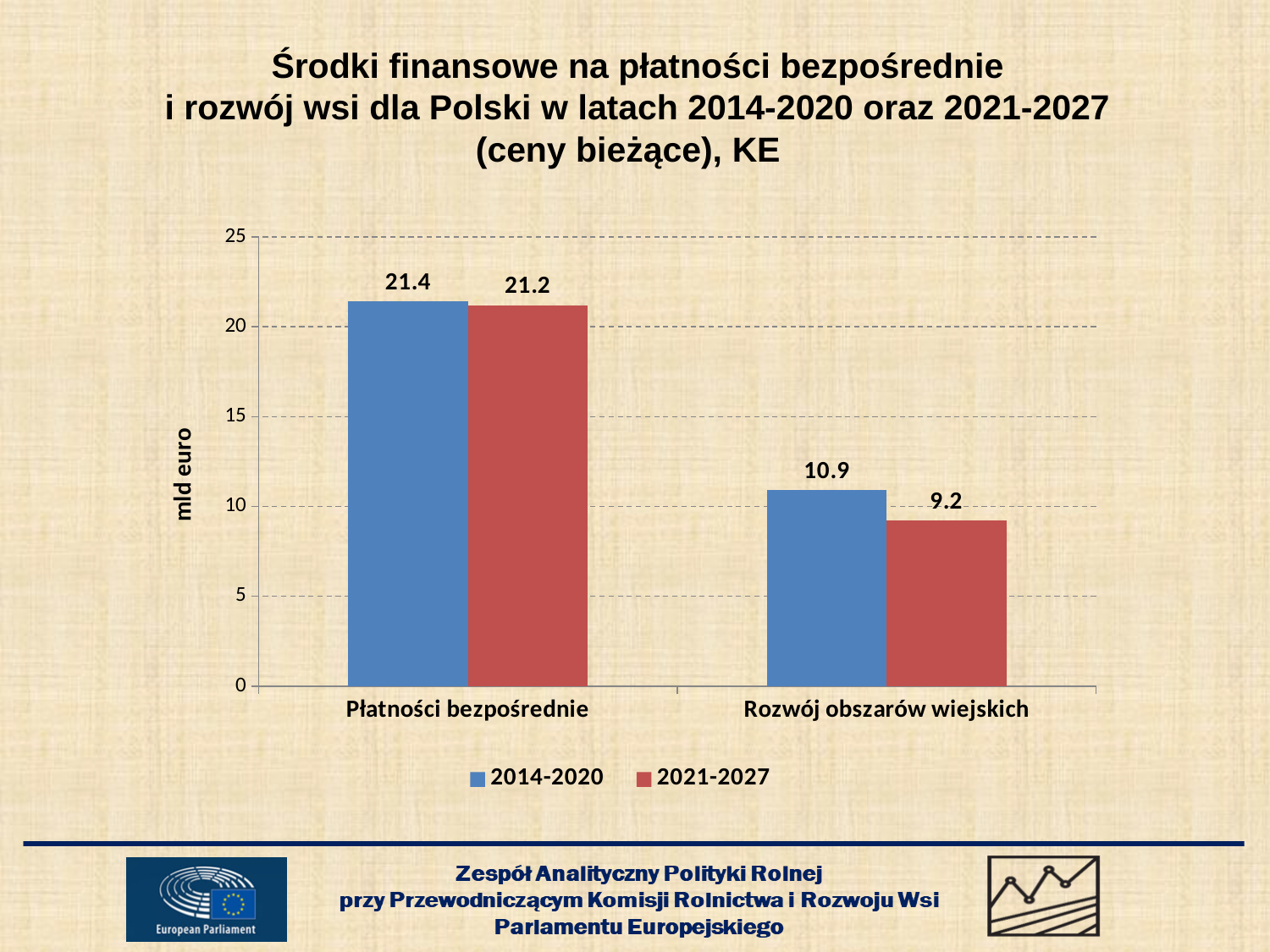
What is the value for Rozwój obszarów wiejskich in the 2021-2027 series? 9.2 What is the value for Rozwój obszarów wiejskich in the 2014-2020 series? 10.9 What kind of chart is shown on the slide? Bar chart How many categories are shown on the x axis? 2 Which category has the highest value in the 2014-2020 series? Płatności bezpośrednie What is the value for Płatności bezpośrednie in the 2014-2020 series? 21.4 Which category has the lowest value in the 2021-2027 series? Rozwój obszarów wiejskich What is the value for Płatności bezpośrednie in the 2021-2027 series? 21.2 What is the difference between the 2014-2020 and 2021-2027 values for Rozwój obszarów wiejskich? 1.7 How many series does the legend list? 2 What is the difference between the 2014-2020 and 2021-2027 values for Płatności bezpośrednie? 0.2 For Rozwój obszarów wiejskich, which series has the larger value, 2014-2020 or 2021-2027? 2014-2020